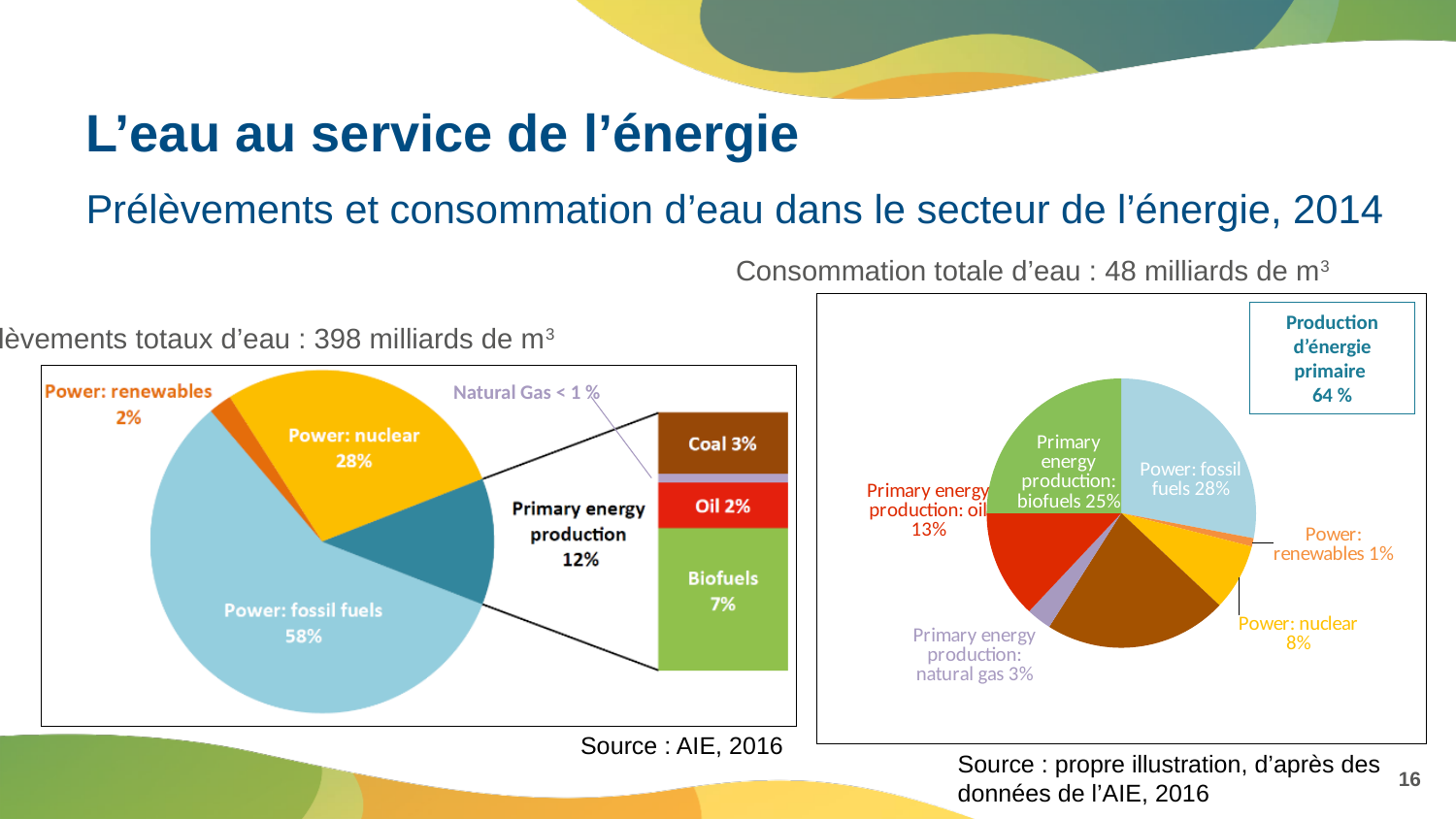
In the left pie chart (Prélèvements totaux d'eau), which category has the largest share? Power: fossil fuels In the right pie chart (Consommation totale d'eau), what share is labelled for Primary energy production: oil? 13% In the left chart, what share of the Primary energy production breakdown is labelled for Biofuels? 7% In the right pie chart (Consommation totale d'eau), which category has the smallest share? Power: renewables In the right pie chart (Consommation totale d'eau), what share is labelled for Power: nuclear? 8% What type of chart is used on the right side of the slide (Consommation totale d'eau)? Pie chart In the left pie chart (Prélèvements totaux d'eau), what share is labelled for Power: fossil fuels? 58% In the right pie chart (Consommation totale d'eau), what share is labelled for Primary energy production: biofuels? 25% In the left pie chart (Prélèvements totaux d'eau), what is the difference in percentage points between Power: fossil fuels and Power: nuclear? 30 percentage points In the left pie chart (Prélèvements totaux d'eau), what share is labelled for Primary energy production? 12% In the right pie chart (Consommation totale d'eau), which is larger: Power: fossil fuels or Primary energy production: biofuels? Power: fossil fuels In the left pie chart (Prélèvements totaux d'eau), what share is labelled for Power: nuclear? 28%